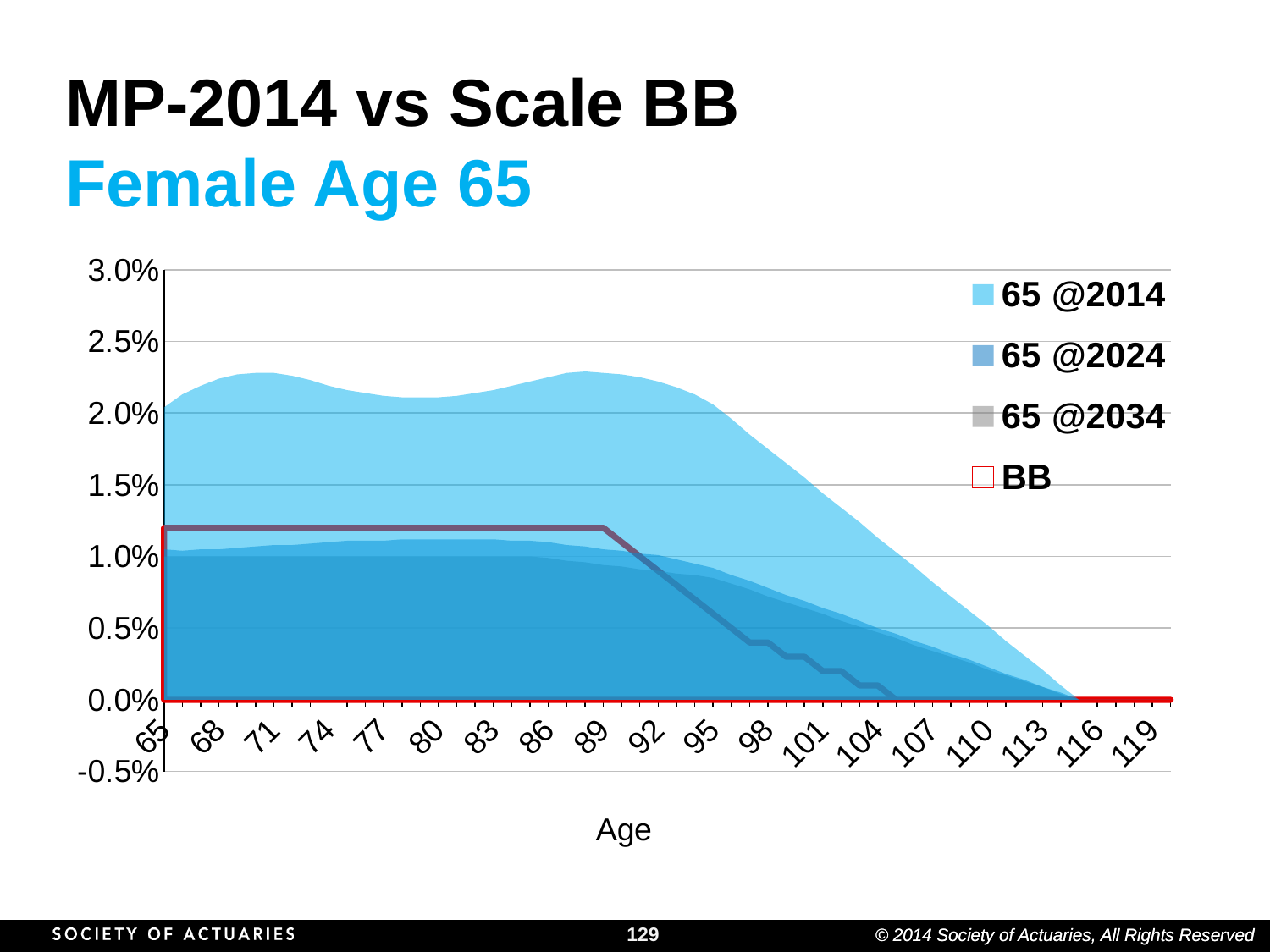
Is the value of the 65 @2024 series at age 80 greater or less than 1.5%? less Is the value of the 65 @2014 series at age 89 greater or less than 2.0%? greater Does the BB series rise or fall between age 89 and age 104? fall Does the 65 @2014 series rise or fall between age 95 and age 113? fall What is the title of the x axis? Age Is the value of the BB series at age 65 greater or less than 1.5%? less What kind of chart is shown on the slide? area chart How many series does the legend list? 4 At age 71, which is larger: the 65 @2014 series or the 65 @2024 series? 65 @2014 Which series reaches the highest value on the chart? 65 @2014 Which series is drawn as a red line rather than a filled area? BB